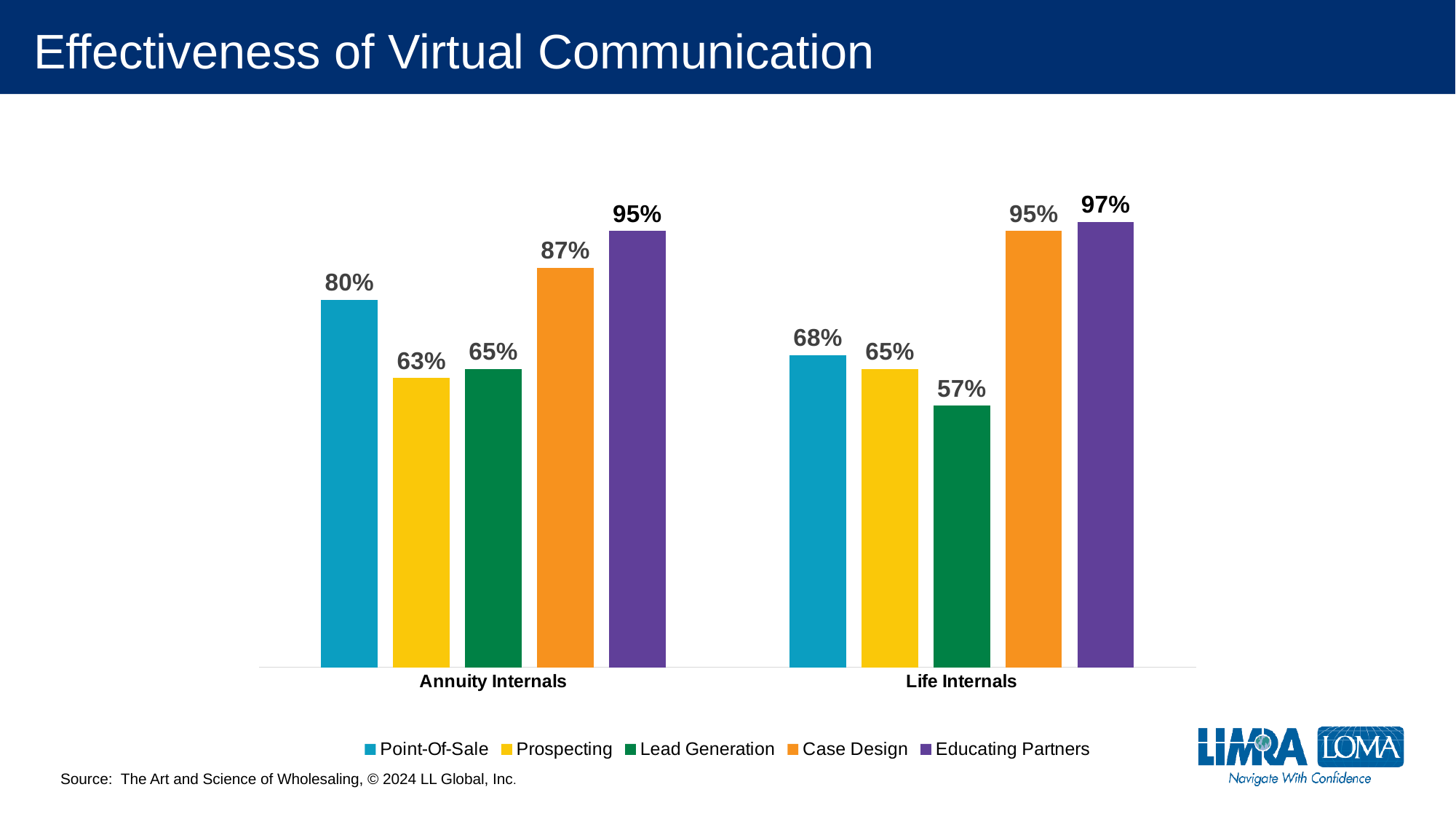
Which series has the highest value in the Life Internals group? Educating Partners What is the title of the slide? Effectiveness of Virtual Communication Which series has the lowest value in the Annuity Internals group? Prospecting What is the value for Point-Of-Sale in the Annuity Internals group? 80% What is the value for Lead Generation in the Life Internals group? 57% What is the difference between Case Design and Lead Generation in the Life Internals group? 38% Which is larger: Point-Of-Sale for Annuity Internals or Point-Of-Sale for Life Internals? Annuity Internals What is the value for Case Design in the Annuity Internals group? 87% How many category groups are shown on the x axis? 2 What is the difference between Educating Partners and Point-Of-Sale in the Annuity Internals group? 15% How many series does the legend list? 5 What kind of chart is shown on the slide? Bar chart